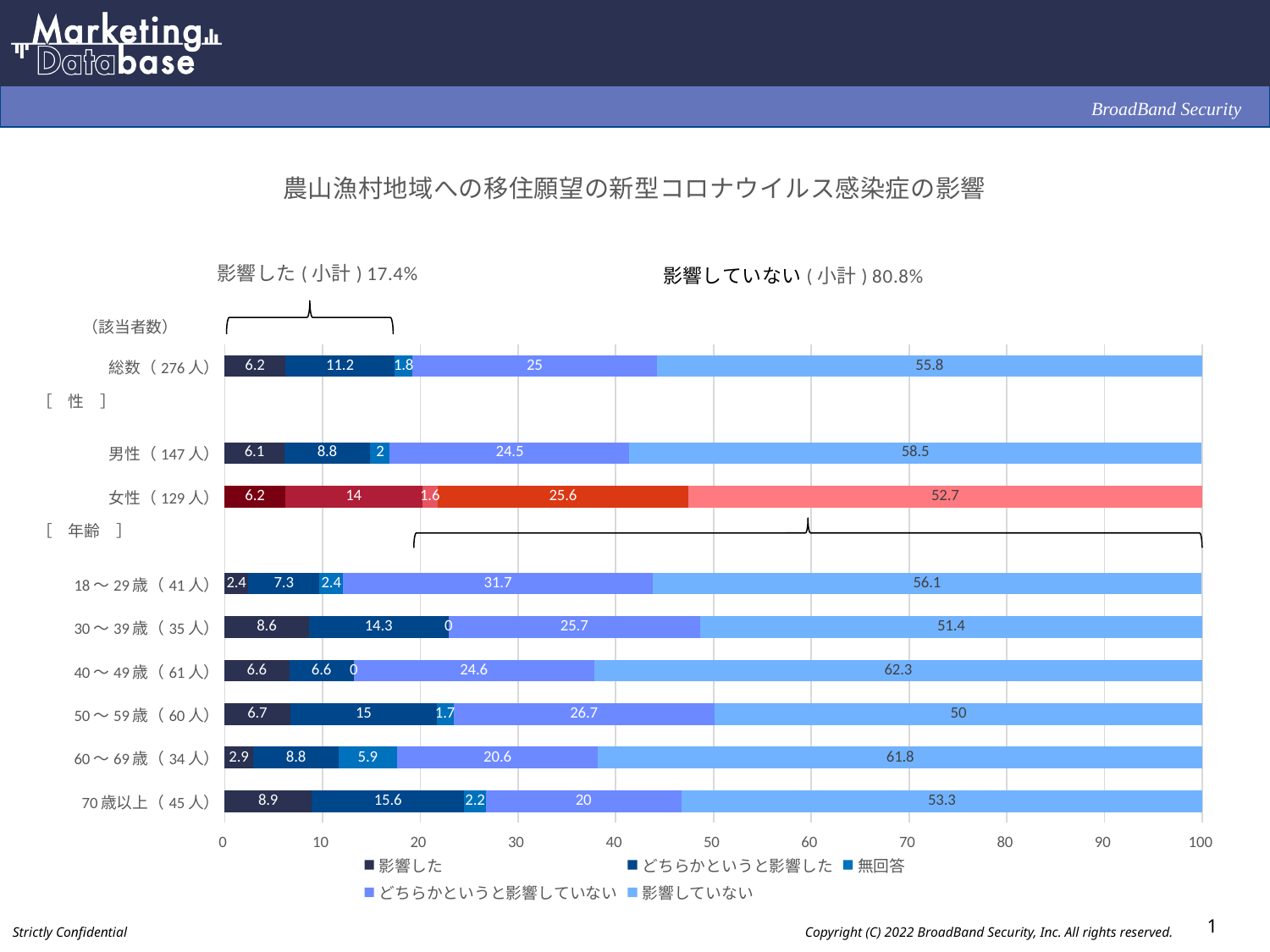
What subtotal percentage is shown for 影響した (小計)? 17.4% Which category has the highest value for 影響していない? 40〜49歳 (61人) What is the difference between the 影響していない values for 男性 (147人) and 女性 (129人)? 5.8 Which is larger, the 影響した value for 70歳以上 (45人) or for 30〜39歳 (35人)? 70歳以上 (45人) What is the value of 無回答 for 60〜69歳 (34人)? 5.9 What is the total of the stacked bar for 総数 (276人)? 100 How many categories (rows) are plotted in the chart? 9 Which category has the lowest value for 影響していない? 50〜59歳 (60人) What kind of chart is shown on the slide? Stacked bar chart How many series does the legend list? 5 What is the value of どちらかというと影響した for 女性 (129人)? 14 What is the value of 影響していない for 総数 (276人)? 55.8